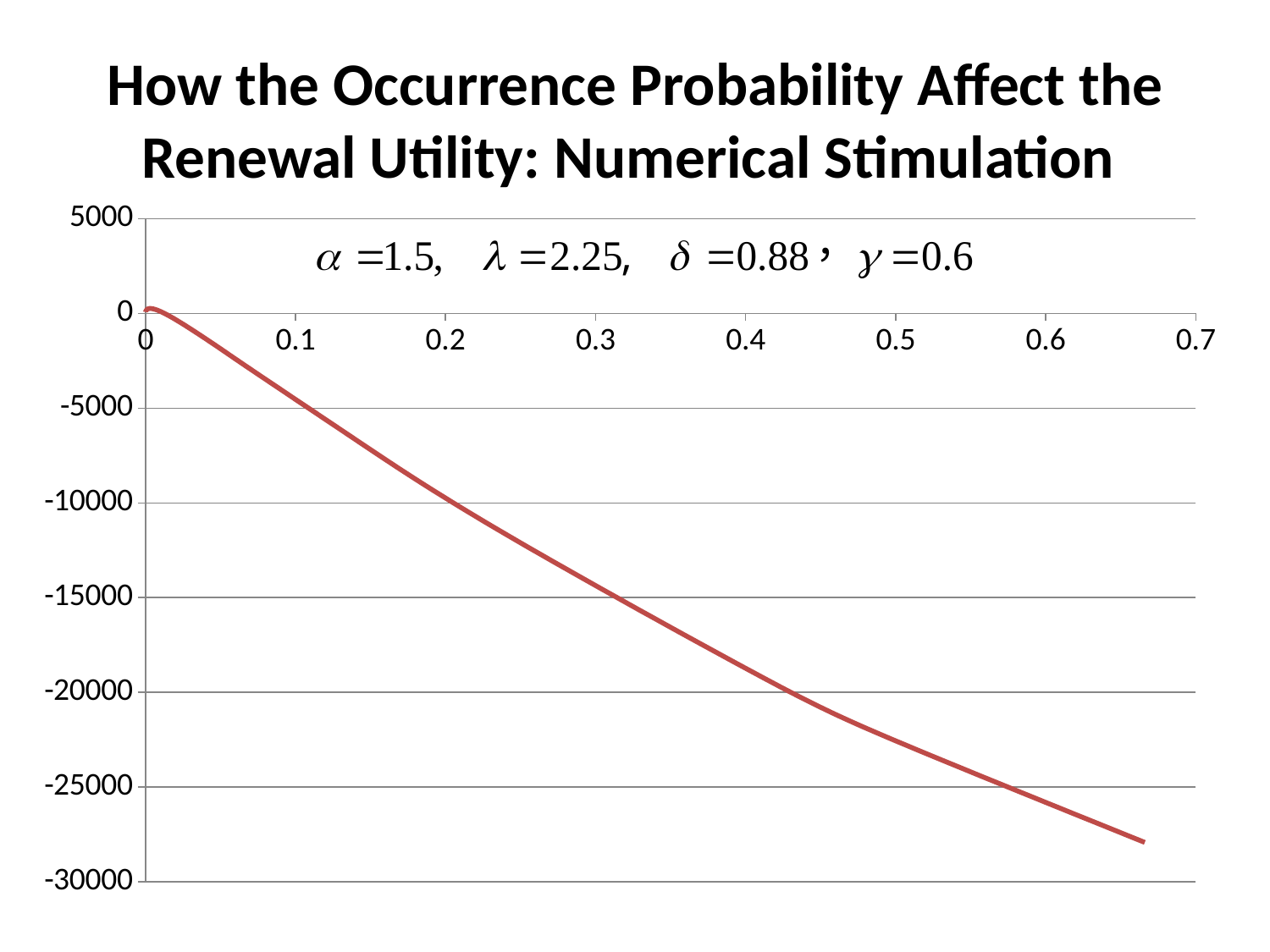
Is the plotted value at x = 0.2 larger or smaller than the value at x = 0.5? larger What value of λ is stated in the parameter annotation on the chart? 2.25 Do the plotted values rise or fall as the x-axis value increases from 0 to 0.7? fall Is the plotted value at x = 0 greater or less than -5000? greater Is the plotted value at x = 0.6 greater or less than -20000? less At which end of the x-axis, left (x = 0) or right (x near 0.7), does the curve reach its lowest value? right Is the plotted value at x = 0.5 greater or less than -20000? less What kind of chart is shown on the slide? line chart What is the title of the chart on the slide? How the Occurrence Probability Affect the Renewal Utility: Numerical Stimulation